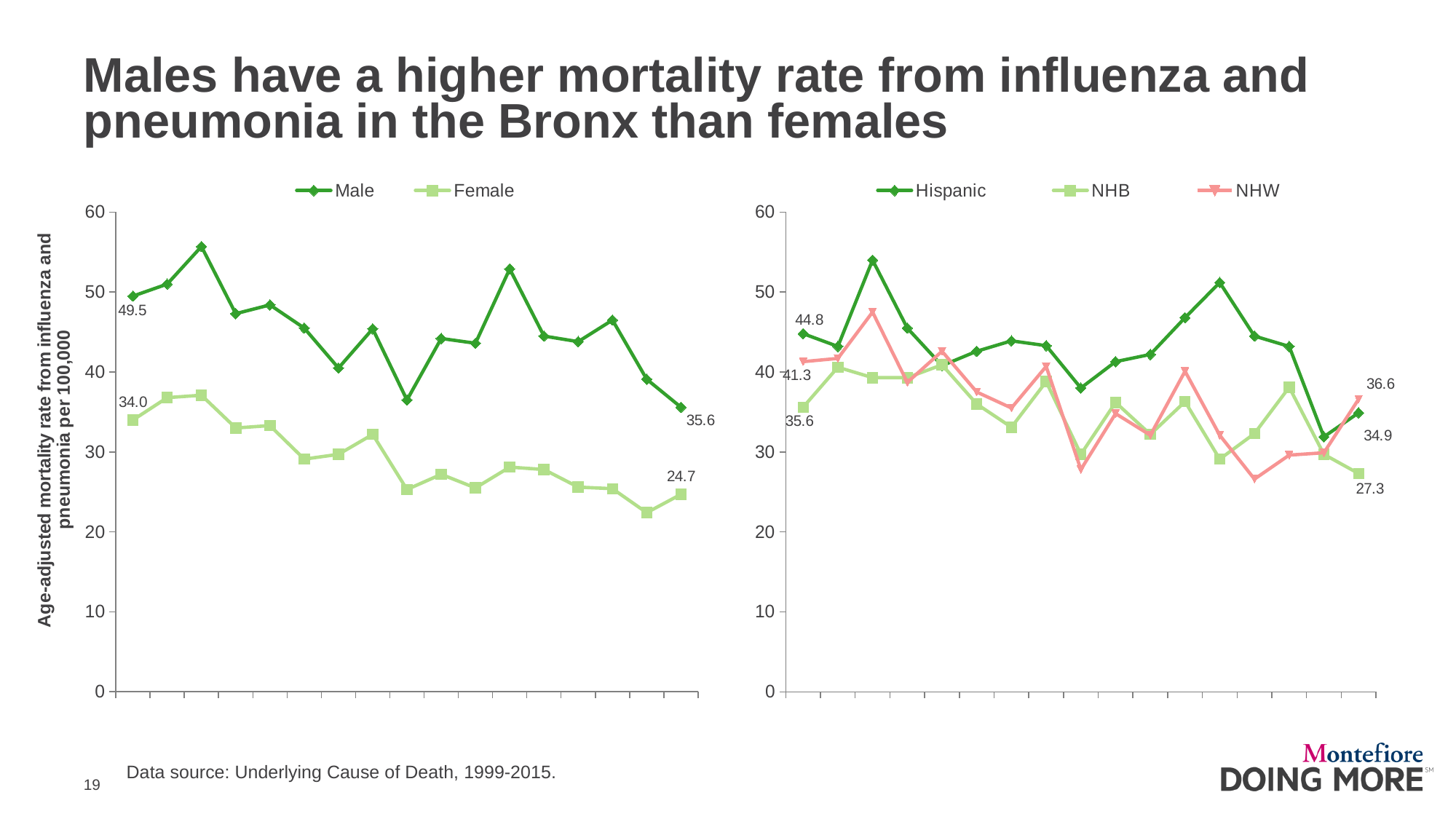
How many series does the legend of the left chart list? 2 How many series does the legend of the right chart list? 3 In the left chart, does the Female series generally rise or fall from left to right? Fall What kind of chart is the left chart (Male vs Female)? Line chart In the right chart, which series has the larger last labelled value, NHW (36.6) or Hispanic (34.9)? NHW In the right chart, is the highest point of the Hispanic series greater or less than 50? greater In the left chart, what is the difference between the last labelled Male value (35.6) and the last labelled Female value (24.7)? 10.9 In the left chart, what is the last labelled value for the Female series? 24.7 In the right chart, what is the first labelled value for the Hispanic series? 44.8 In the right chart, what is the last labelled value for the NHB series? 27.3 In the left chart, what is the difference between the first labelled Male value (49.5) and the first labelled Female value (34.0)? 15.5 In the left chart, what is the first labelled value for the Male series? 49.5